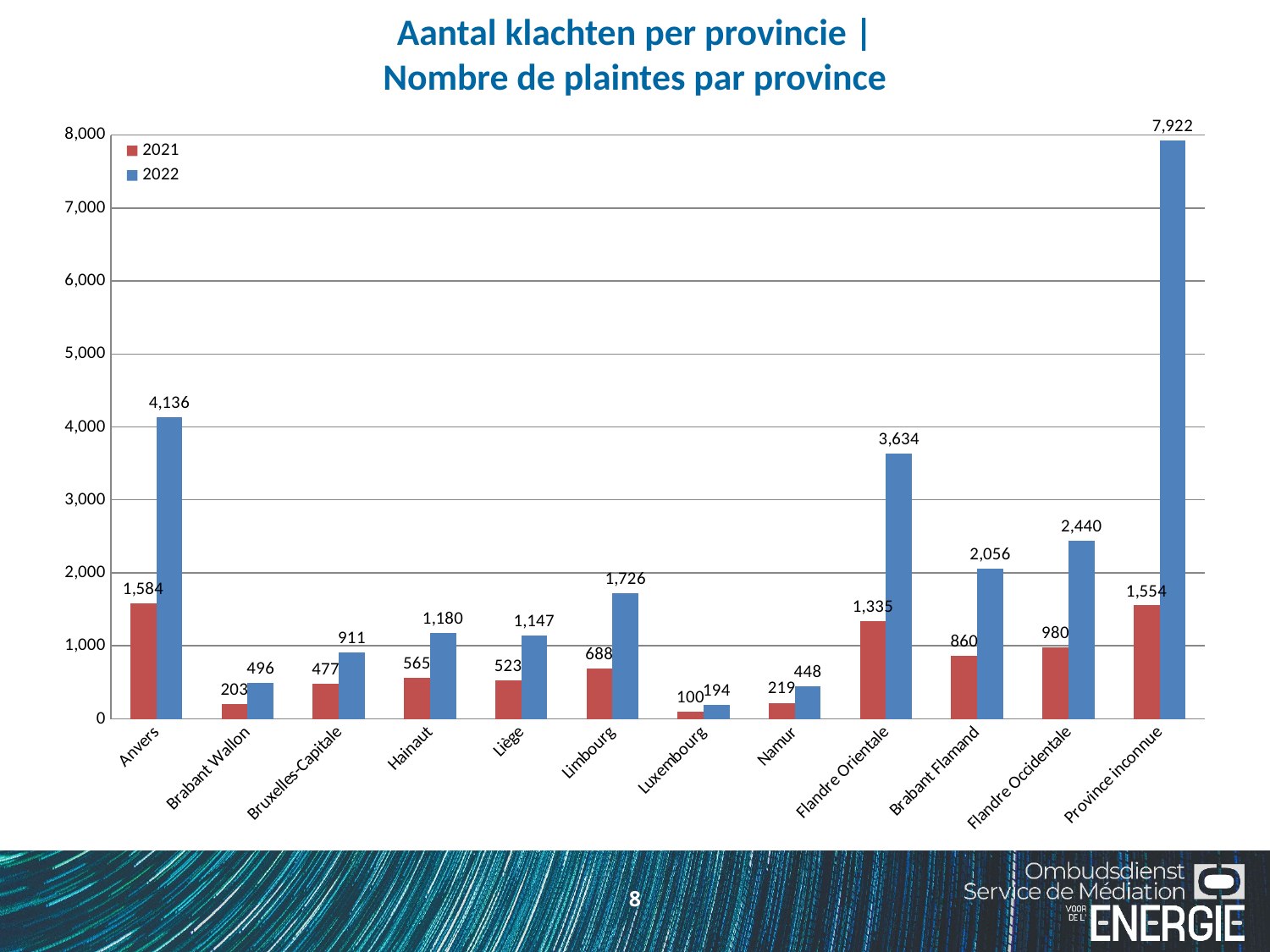
How many provinces (categories) are shown on the x axis? 12 What is the difference between the 2022 and 2021 values for Brabant Flamand? 1,196 Which is larger, the 2021 value for Anvers or the 2021 value for Province inconnue? Anvers Is the 2022 value for Flandre Occidentale greater or less than 2,000? greater Which category has the lowest 2021 value? Luxembourg How many series does the legend list? 2 Which colour represents the 2021 series in the legend? red What is the 2022 value for Anvers? 4,136 What is the 2021 value for Flandre Orientale? 1,335 What is the 2022 value for Luxembourg? 194 Which category has the highest 2022 value? Province inconnue What kind of chart is shown on the slide? bar chart